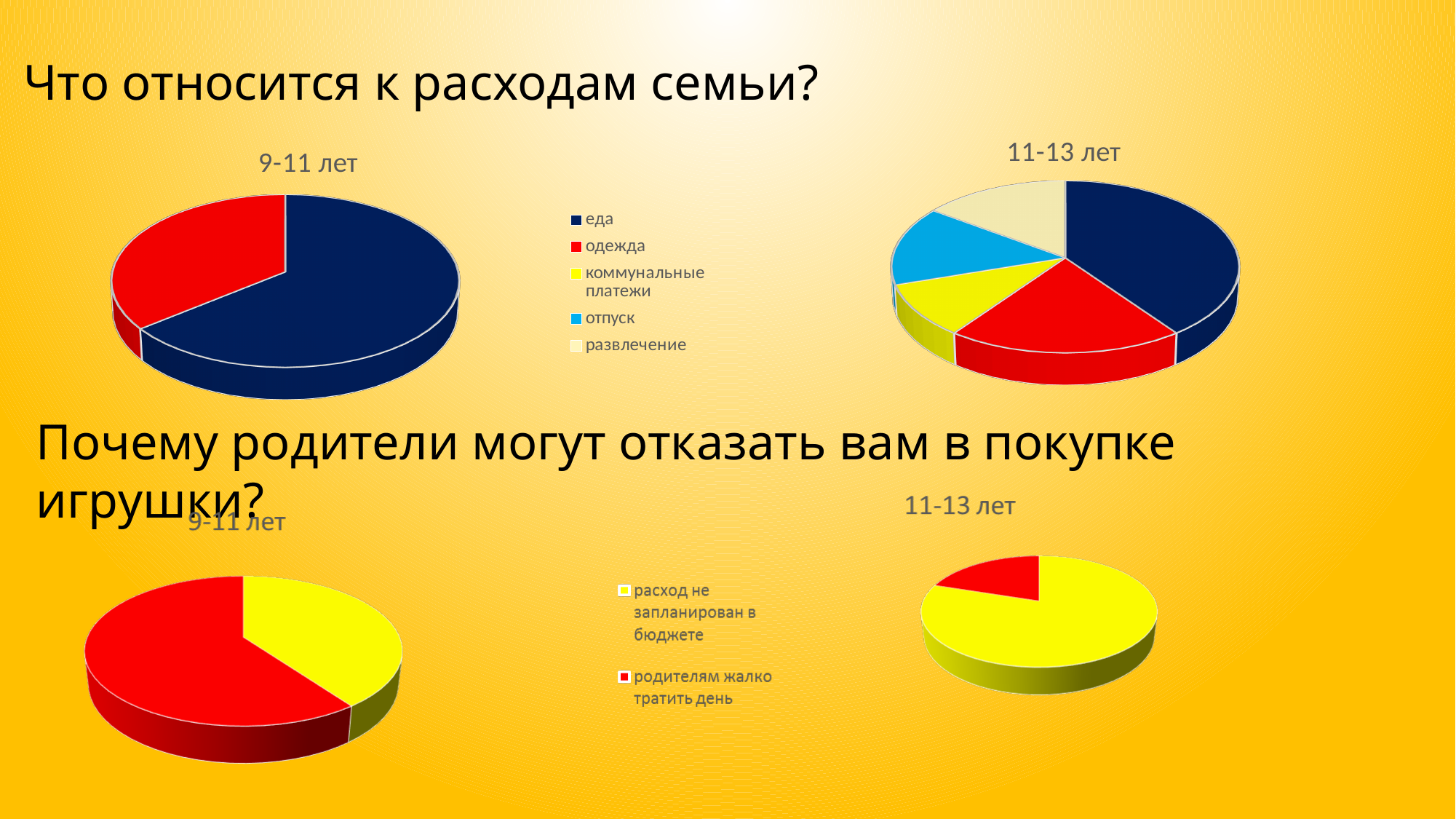
What kind of chart is the top-left chart titled "9-11 лет"? pie chart How many entries does the legend between the two top pie charts list? 5 In the top-right pie chart titled "11-13 лет", which slice is larger: одежда or отпуск? одежда In the legend for the top pie charts, which colour represents "коммунальные платежи"? yellow How many entries does the legend between the two bottom pie charts list? 2 In the top-left pie chart titled "9-11 лет", which slice is larger: еда or одежда? еда In the bottom-left pie chart titled "9-11 лет", which slice is larger: "расход не запланирован в бюджете" or "родителям жалко тратить день"? родителям жалко тратить день In the top-right pie chart titled "11-13 лет", which category has the largest slice? еда How many slices does the top-left pie chart titled "9-11 лет" have? 2 How many slices does the top-right pie chart titled "11-13 лет" have? 5 In the bottom-right pie chart titled "11-13 лет", which category has the largest slice? расход не запланирован в бюджете What is the title of the top-right pie chart? 11-13 лет